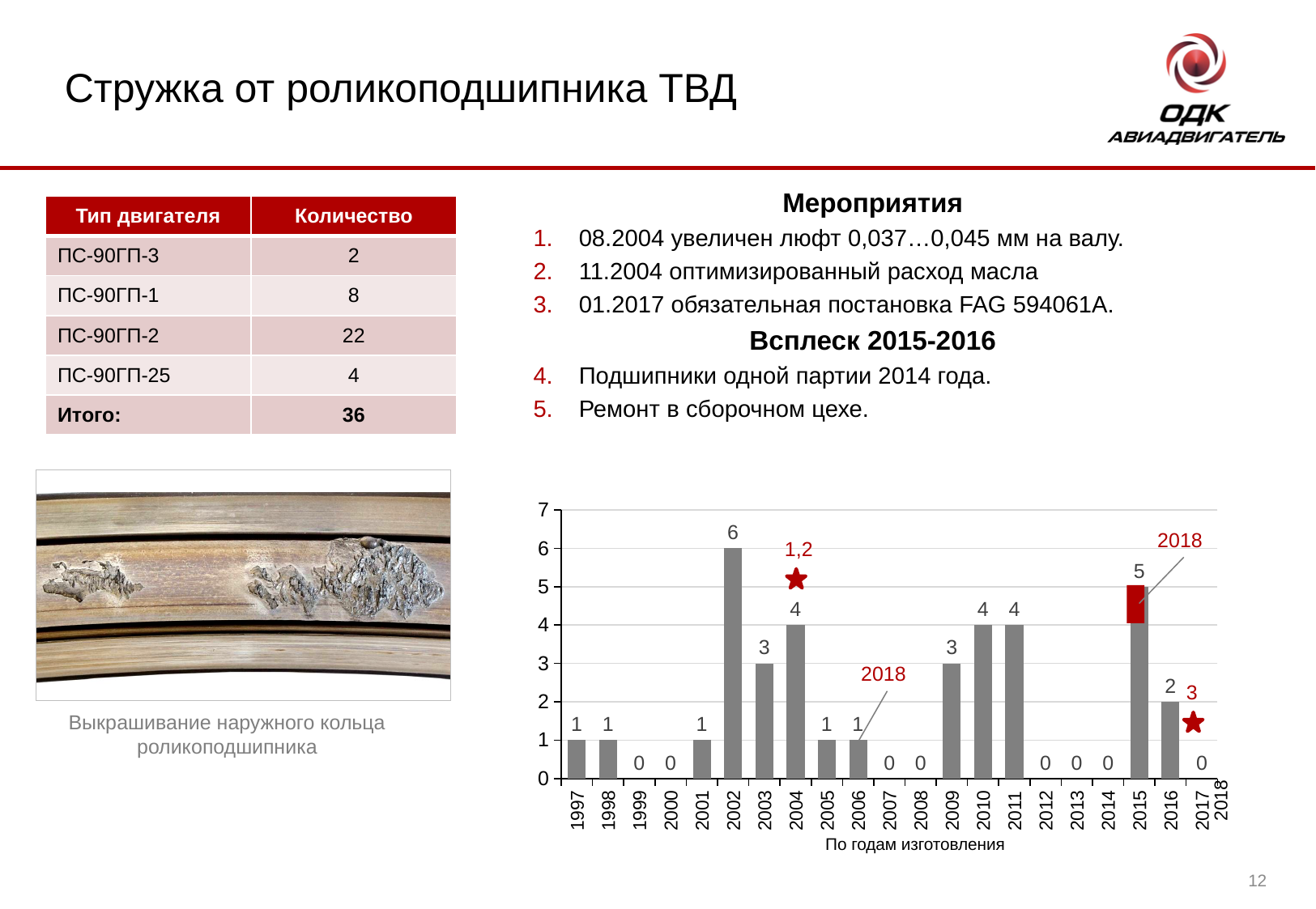
What is the difference between the values for 2002 and 2015? 1 What is the value for 2010 on the chart? 4 Which has a larger value, 2010 or 2016? 2010 Do the values rise or fall from 2014 to 2015? rise How many years on the chart show a value of 0? 8 What is the title of the x axis of the chart? По годам изготовления What kind of chart is shown on the slide? bar chart What is the value for 2016 on the chart? 2 Which year has the highest value on the chart? 2002 What is the total of the stacked bar for 2015? 5 Is the value for 2002 greater or less than 5? greater What is the value for 2002 on the chart? 6